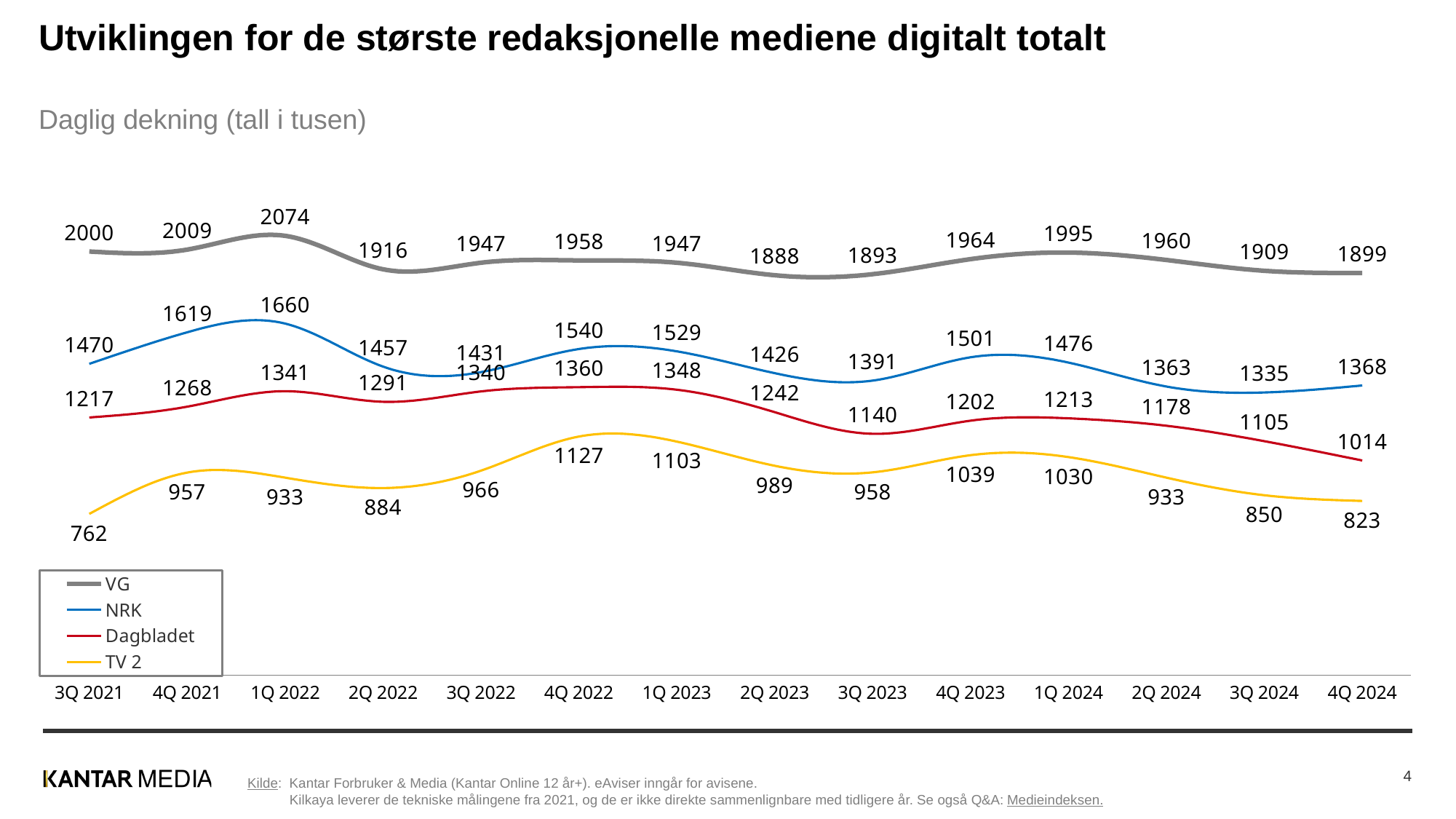
Which is larger in 3Q 2023: Dagbladet or TV 2? Dagbladet How many series does the legend list? 4 What is the value for NRK in 4Q 2022? 1540 What is the value for TV 2 in 3Q 2021? 762 What kind of chart is shown on the slide? Line chart In which quarter does NRK reach its highest value? 1Q 2022 How many quarters are shown on the x axis? 14 In which quarter does TV 2 have its lowest value? 3Q 2021 What is the difference between VG and NRK in 4Q 2024? 531 What is the value for VG in 1Q 2022? 2074 What is the value for Dagbladet in 4Q 2024? 1014 Does the Dagbladet line rise or fall from 1Q 2024 to 4Q 2024? Fall